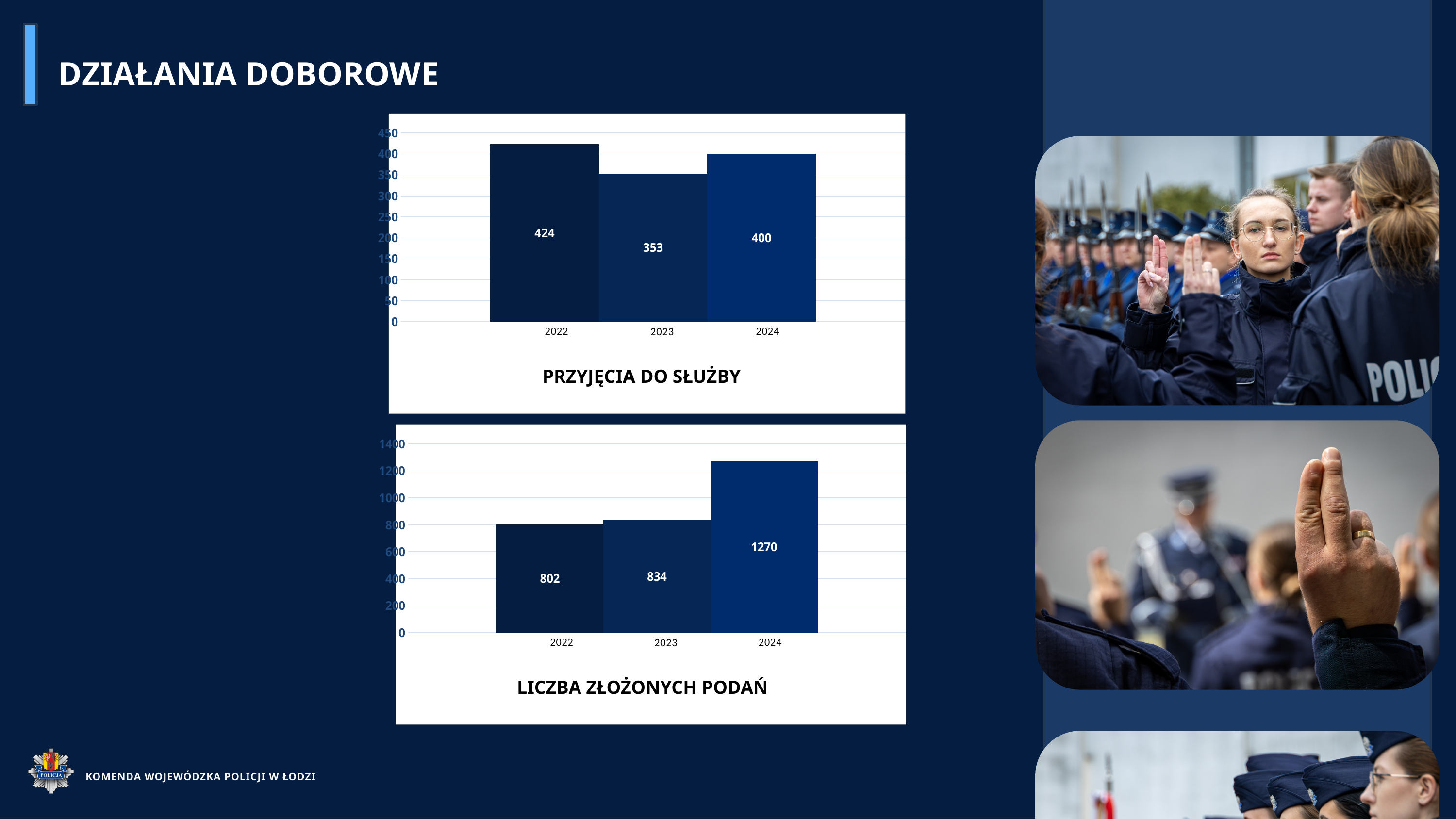
In the chart titled PRZYJĘCIA DO SŁUŻBY, what is the value for 2023? 353 In the chart titled PRZYJĘCIA DO SŁUŻBY, what is the difference between the values for 2022 and 2024? 24 In the chart titled PRZYJĘCIA DO SŁUŻBY, which year has the lowest value? 2023 In the chart titled LICZBA ZŁOŻONYCH PODAŃ, what is the difference between the values for 2024 and 2023? 436 In the chart titled LICZBA ZŁOŻONYCH PODAŃ, what is the value for 2022? 802 In the chart titled LICZBA ZŁOŻONYCH PODAŃ, which year has the highest value? 2024 In the chart titled PRZYJĘCIA DO SŁUŻBY, what is the value for 2022? 424 In the chart titled PRZYJĘCIA DO SŁUŻBY, which year has the highest value? 2022 In the chart titled LICZBA ZŁOŻONYCH PODAŃ, do the values rise or fall from 2022 to 2024? rise What kind of chart is the chart titled LICZBA ZŁOŻONYCH PODAŃ? bar chart In the chart titled LICZBA ZŁOŻONYCH PODAŃ, what is the value for 2024? 1270 How many bars does the chart titled PRZYJĘCIA DO SŁUŻBY have? 3